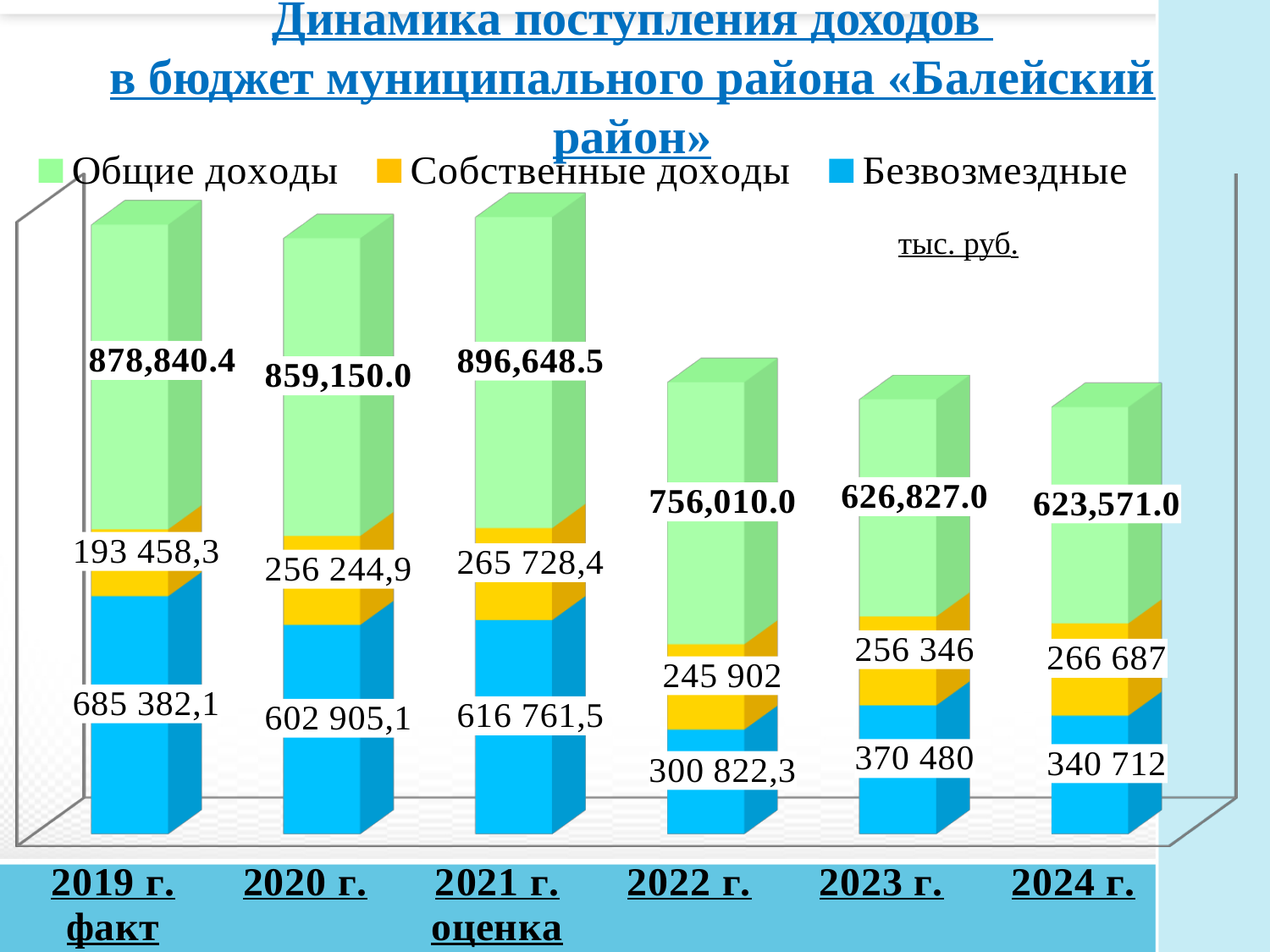
What is the value of Собственные доходы for 2024 г.? 266 687 In which year is Общие доходы the lowest? 2024 г. Does Общие доходы rise or fall from 2021 г. to 2024 г.? fall What is the difference between Общие доходы in 2019 г. факт and 2020 г.? 19,690.4 How many series does the legend list? 3 What is the value of Безвозмездные for 2019 г. факт? 685 382,1 Which is larger: Безвозмездные in 2023 г. or in 2024 г.? 2023 г. How many years are shown on the x axis? 6 What is the value of Общие доходы for 2021 г. оценка? 896,648.5 What is the value of Безвозмездные for 2022 г.? 300 822,3 In which year is Безвозмездные the lowest? 2022 г. In which year is Общие доходы the highest? 2021 г. оценка